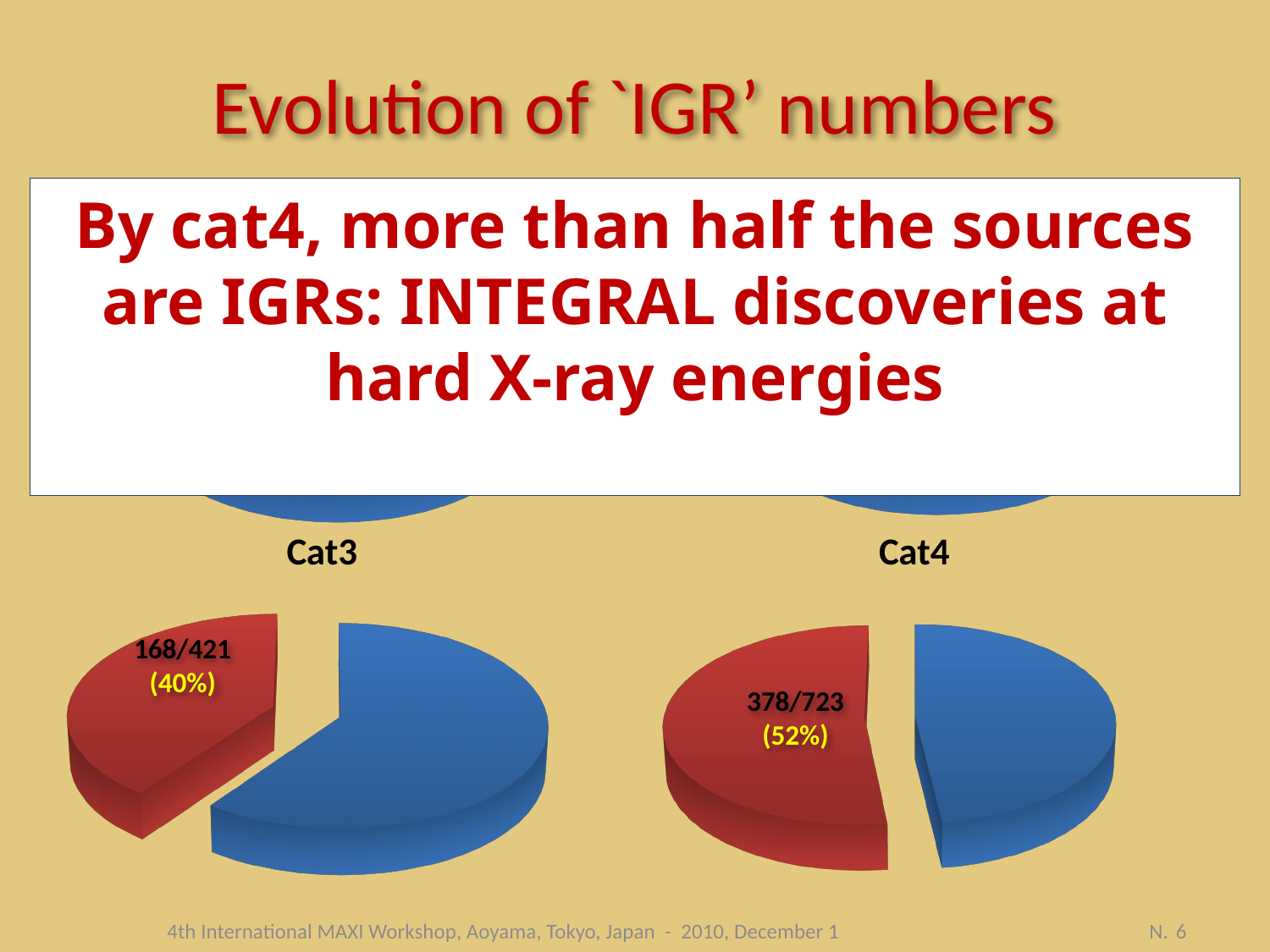
What is the total number of sources in the Cat4 pie chart, as printed in the slice label? 723 In the Cat3 pie chart, is the red slice's share greater or less than 50%? less In the Cat4 pie chart, what percentage share does the red slice represent? 52% In the Cat4 pie chart, what label is printed on the red slice? 378/723 (52%) How many slices does the Cat4 pie chart have? 2 What is the title of the slide containing the pie charts? Evolution of `IGR' numbers In the Cat3 pie chart, which slice is larger, the red one or the blue one? blue What kind of chart is the Cat3 chart? pie chart In the Cat3 pie chart, what label is printed on the red slice? 168/421 (40%) In the Cat4 pie chart, is the red slice's share greater or less than 50%? greater In the Cat3 pie chart, what percentage share does the red slice represent? 40% Which pie chart has the larger red slice, Cat3 or Cat4? Cat4